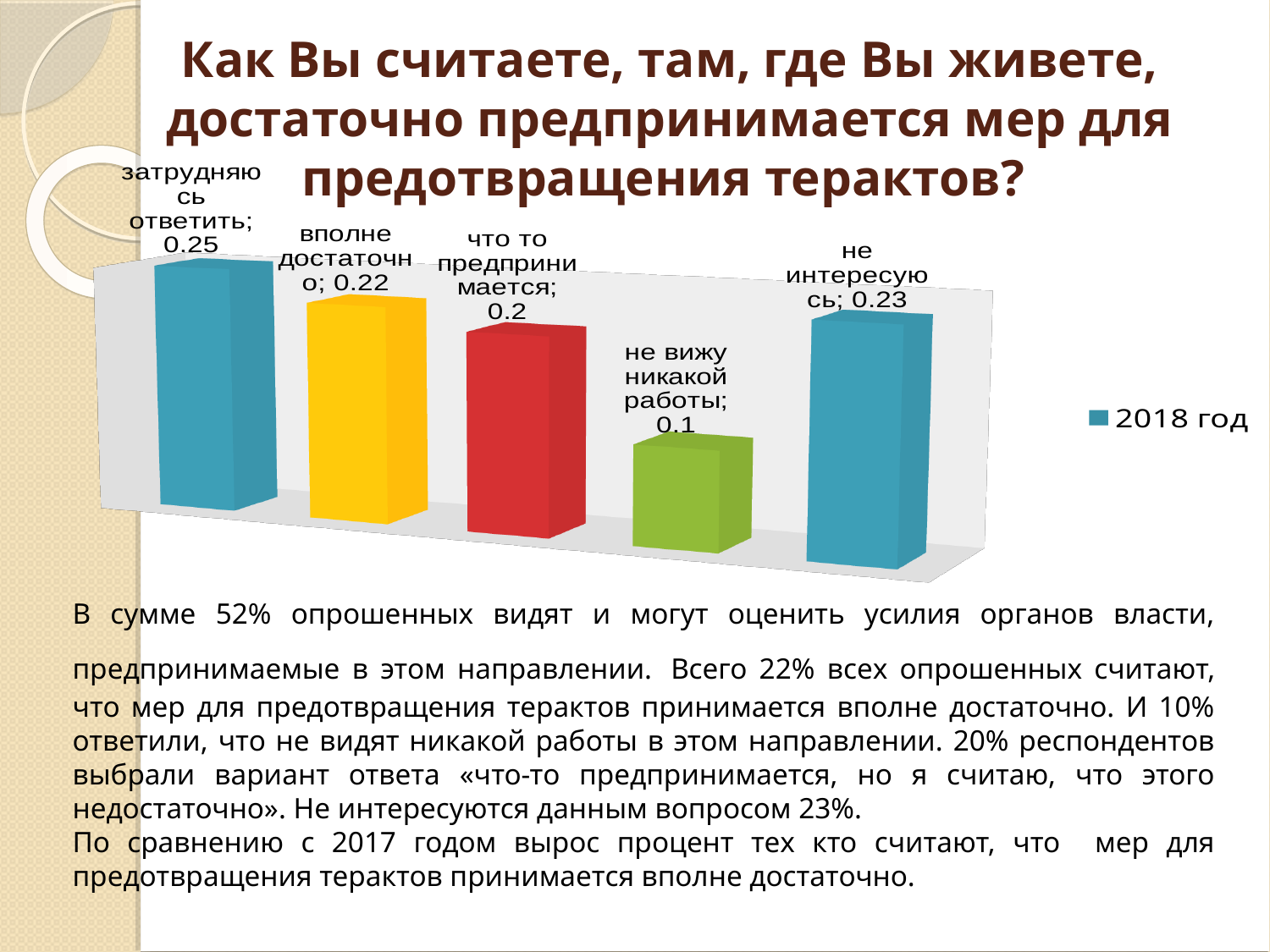
What is the difference between the values for "затрудняюсь ответить" and "не вижу никакой работы"? 0.15 What value is shown for the category "затрудняюсь ответить"? 0.25 What series name is shown in the chart legend? 2018 год Which is larger: the value for "не интересуюсь" or the value for "что то предпринимается"? не интересуюсь How many series does the legend list? 1 What value is shown for the category "не вижу никакой работы"? 0.1 Which category has the highest value? затрудняюсь ответить What value is shown for the category "не интересуюсь"? 0.23 How many categories are shown in the chart? 5 What kind of chart is shown on the slide? bar chart What value is shown for the category "вполне достаточно"? 0.22 Which category has the lowest value? не вижу никакой работы